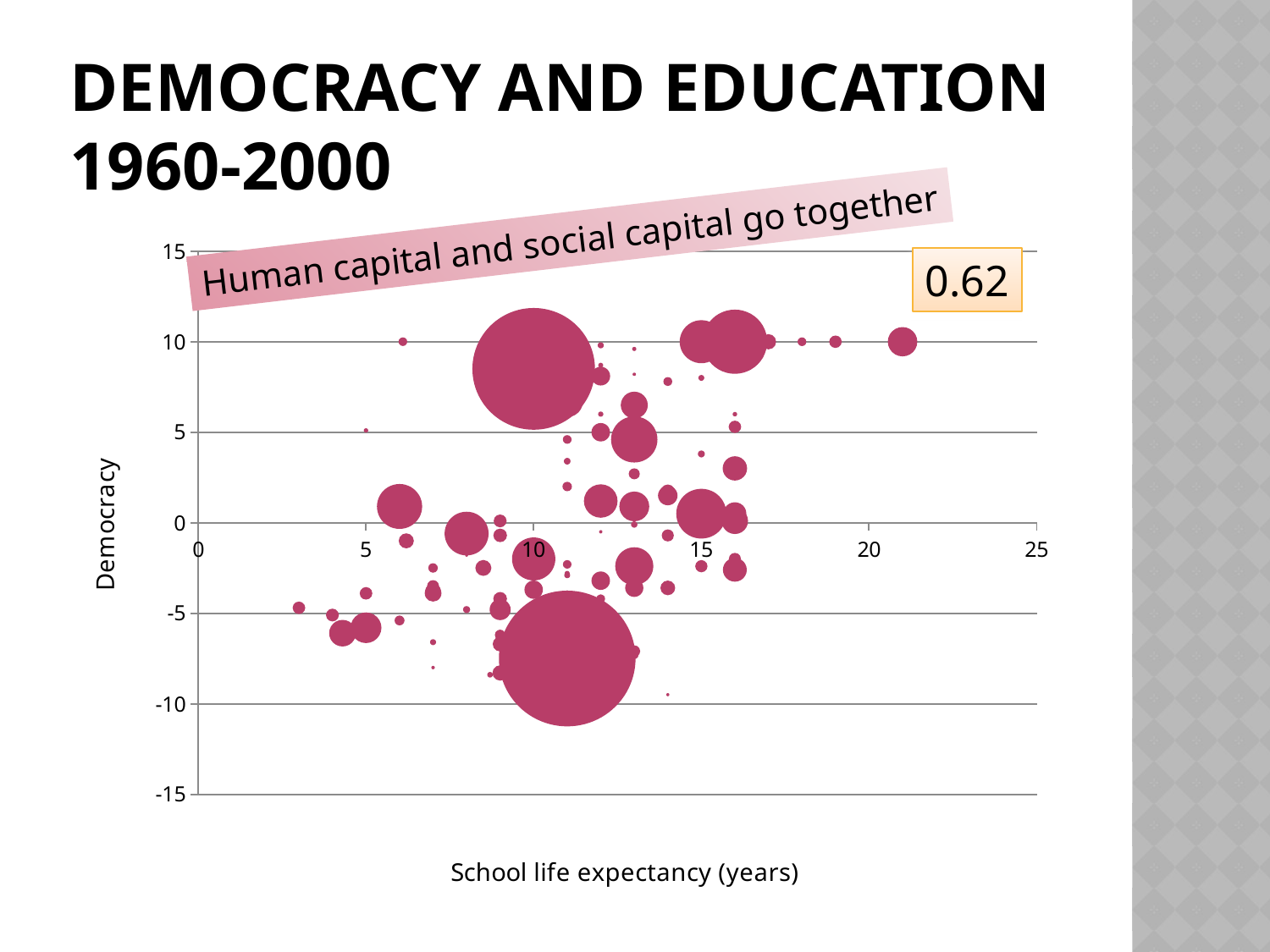
As school life expectancy increases along the x axis, do the democracy values generally rise or fall? rise What number is shown in the box in the upper right corner of the chart? 0.62 What is the lowest value shown on the y axis of the chart? -15 What kind of chart is shown on the slide? bubble chart Is the school life expectancy of the rightmost bubble greater or less than 20? greater What democracy value does the rightmost bubble on the chart sit on? 10 What is the title of the x axis of the chart? School life expectancy (years) What is the highest value shown on the x axis of the chart? 25 Is the democracy value of the largest bubble on the chart greater or less than -5? less What is the title of the y axis of the chart? Democracy Is the school life expectancy of the largest bubble on the chart greater or less than 10? greater